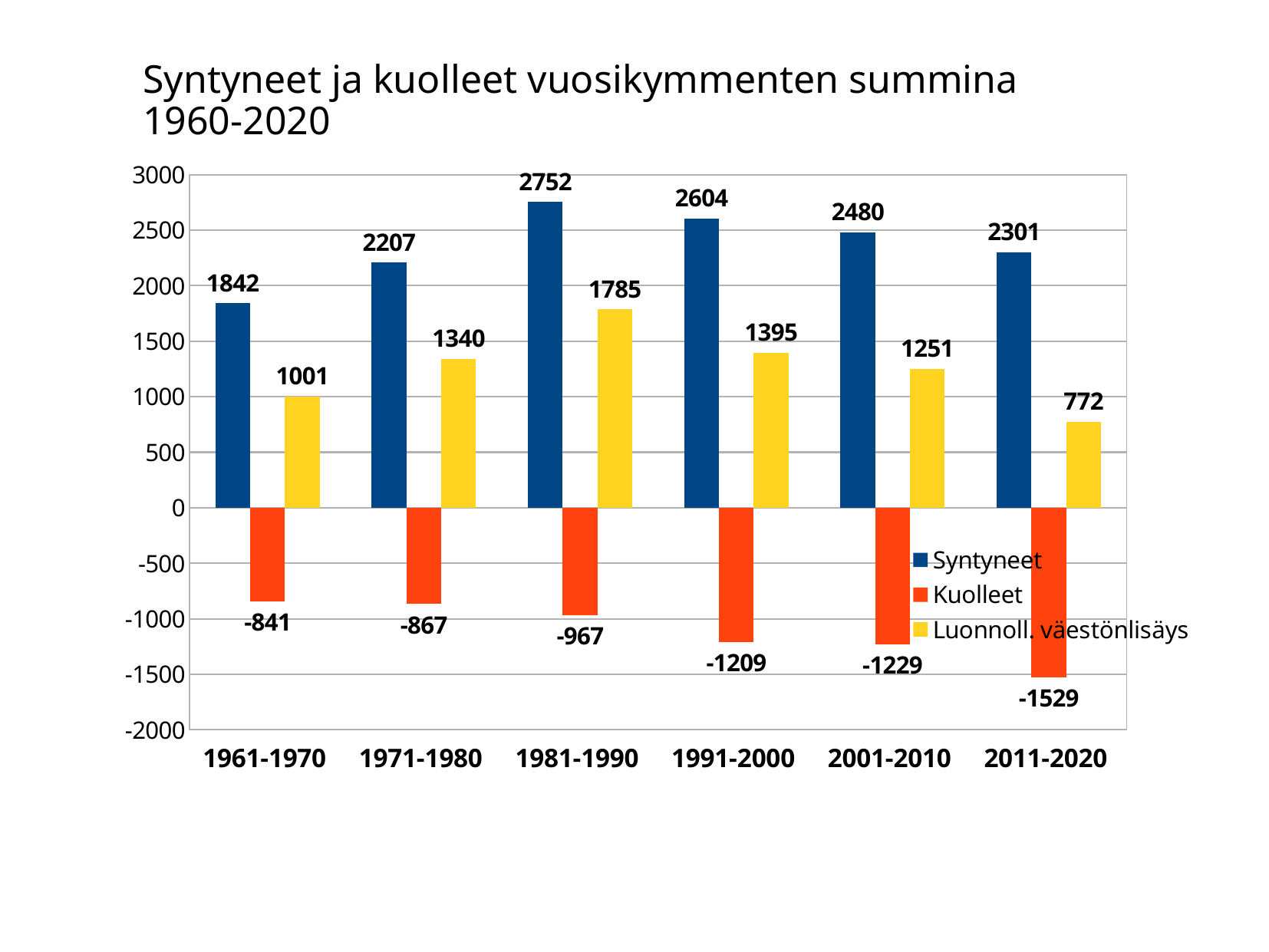
How many decades are shown on the x axis? 6 Which is larger, the Luonnoll. väestönlisäys value for 1991-2000 or for 2001-2010? 1991-2000 What is the value of Luonnoll. väestönlisäys for 1971-1980? 1340 What is the value of Kuolleet for 2011-2020? -1529 What colour are the Kuolleet bars? red How many series does the legend list? 3 Which decade has the lowest Luonnoll. väestönlisäys value? 2011-2020 What is the value of Syntyneet for 1981-1990? 2752 What kind of chart is shown on the slide? bar chart What is the difference between the Syntyneet values for 1981-1990 and 1961-1970? 910 Do the Kuolleet values rise or fall (become more negative) from 1961-1970 to 2011-2020? fall Which decade has the highest Syntyneet value? 1981-1990